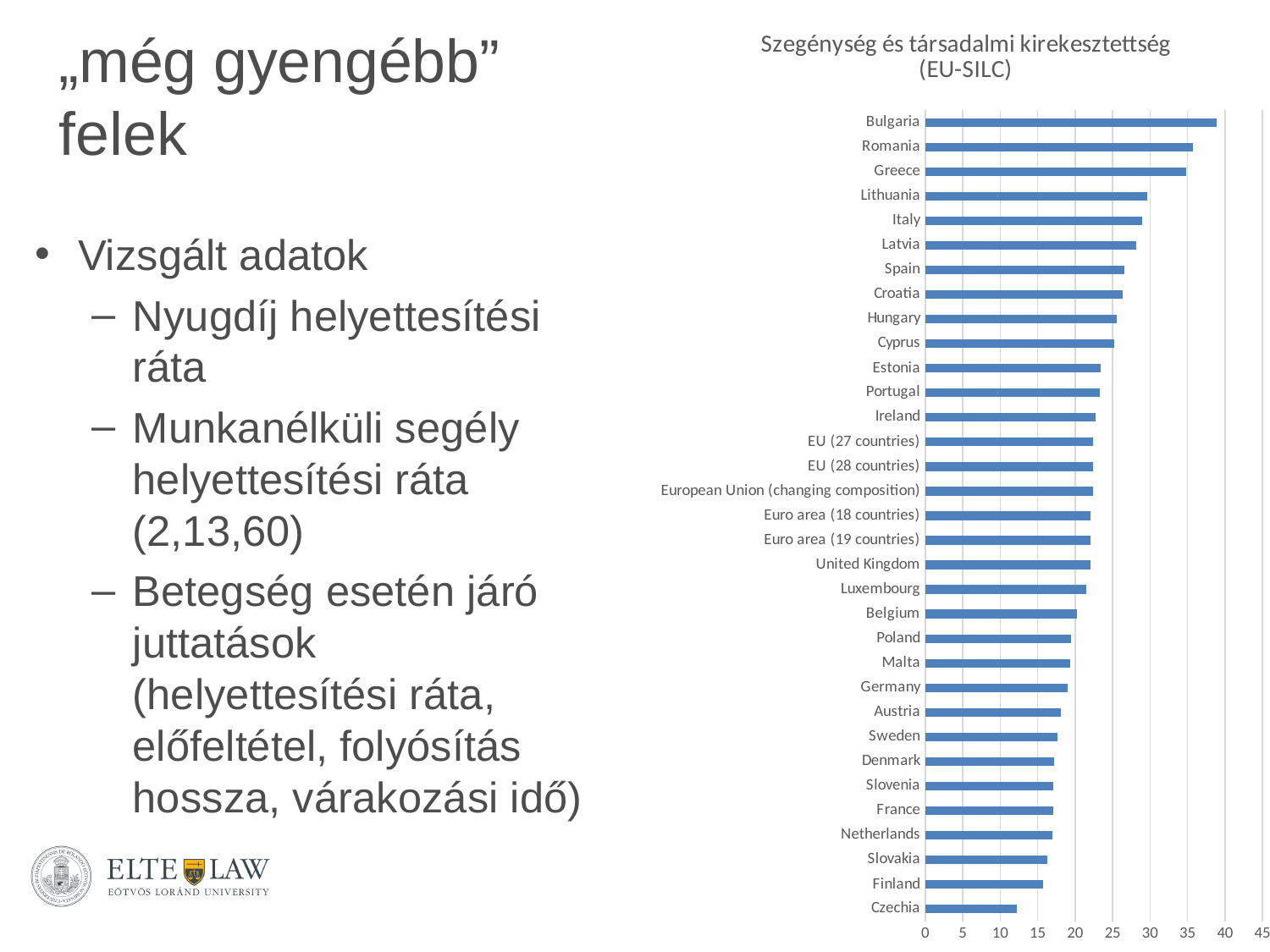
Is the value for Czechia greater or less than 15? less What kind of chart is shown on the slide? bar chart Do the bar values increase or decrease going from the top of the chart to the bottom? decrease How many categories are plotted in the chart? 33 Which category has the highest value in the chart? Bulgaria Which has a larger value, Greece or Poland? Greece Is the value for Spain greater or less than 25? greater Is the value for Netherlands greater or less than 20? less What is the title of the chart? Szegénység és társadalmi kirekesztettség (EU-SILC) Which category has the lowest value in the chart? Czechia